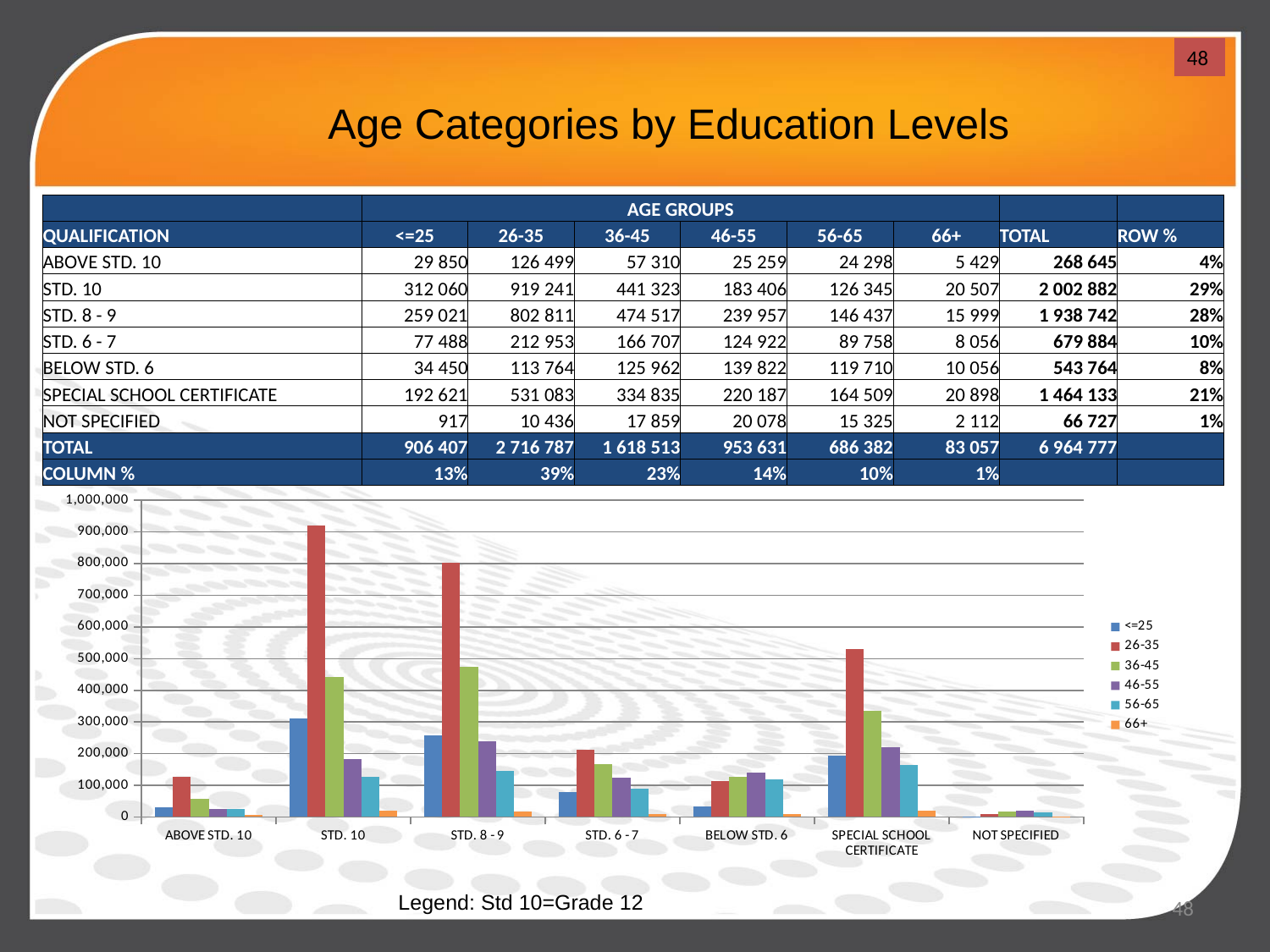
How many qualification categories are plotted along the x axis of the chart? 7 What kind of chart is shown on the slide? bar chart Which qualification category has the lowest bar for the 26-35 age group? NOT SPECIFIED How many series does the chart legend list? 6 Is the <=25 value for STD. 10 greater or less than 400,000? less Which age group is shown in red in the chart legend? 26-35 What is the value for SPECIAL SCHOOL CERTIFICATE in the 66+ age group? 20 898 What is the difference between the 26-35 values for STD. 10 and STD. 8 - 9? 116 430 Which qualification category has the highest bar for the 26-35 age group? STD. 10 What is the value for STD. 10 in the 26-35 age group? 919 241 Is the 26-35 value for STD. 8 - 9 greater or less than 700,000? greater Which is larger for the 36-45 age group: SPECIAL SCHOOL CERTIFICATE or BELOW STD. 6? SPECIAL SCHOOL CERTIFICATE